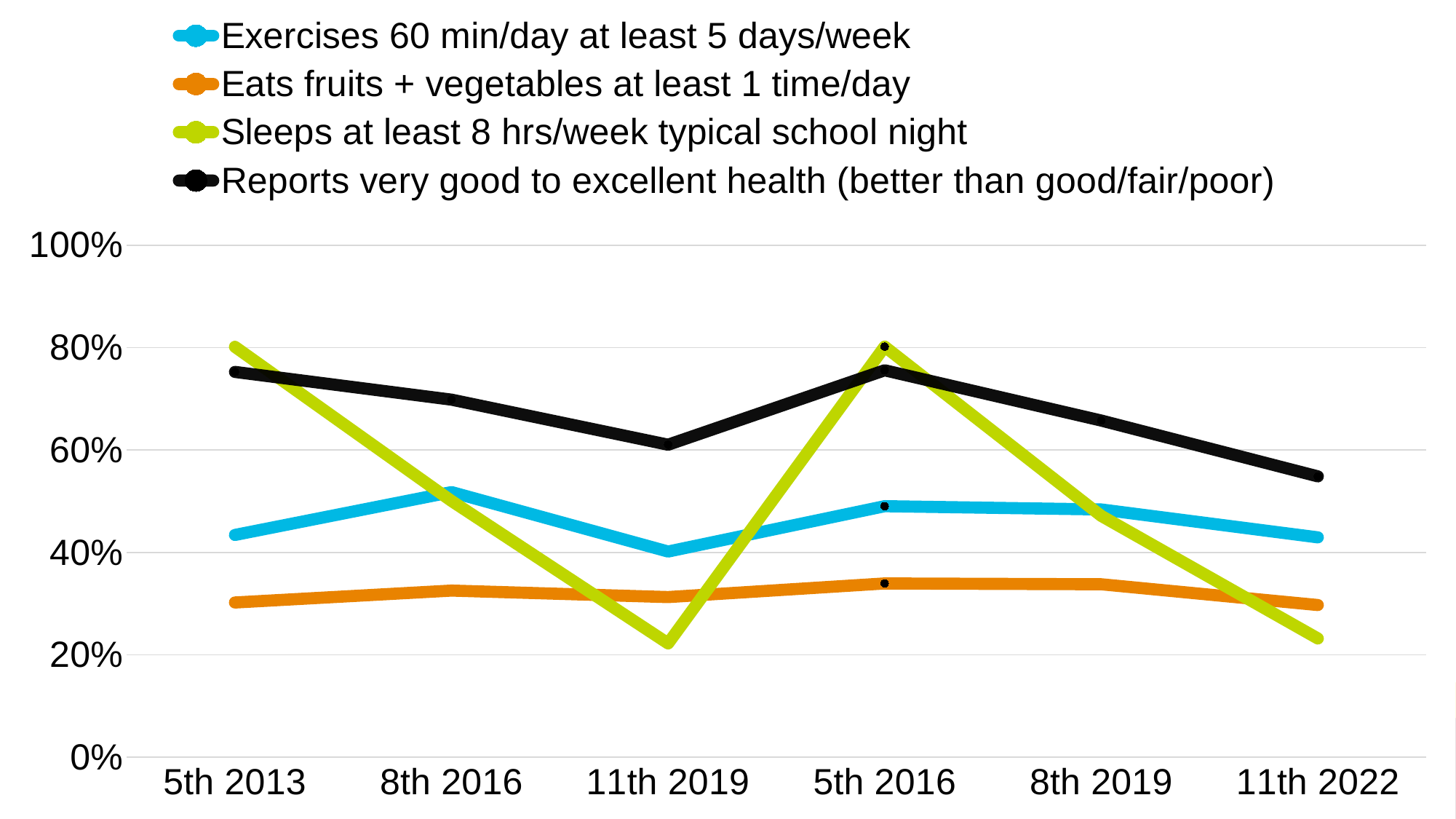
Which series has the lowest value at 11th 2019? Sleeps at least 8 hrs/week typical school night What kind of chart is shown on the slide? line chart Which series has the highest value at 11th 2019? Reports very good to excellent health (better than good/fair/poor) At 11th 2022, which is larger: 'Exercises 60 min/day at least 5 days/week' or 'Eats fruits + vegetables at least 1 time/day'? Exercises 60 min/day at least 5 days/week For 'Reports very good to excellent health', which is larger: the value at 5th 2013 or at 11th 2022? 5th 2013 How many categories are shown along the x axis? 6 What colour is the line for 'Exercises 60 min/day at least 5 days/week'? blue Is the value for 'Reports very good to excellent health' at 5th 2013 greater or less than 60%? greater Is the value for 'Eats fruits + vegetables at least 1 time/day' at 8th 2019 greater or less than 40%? less How many series does the legend list? 4 Is the value for 'Sleeps at least 8 hrs/week typical school night' at 11th 2019 greater or less than 40%? less Does the 'Reports very good to excellent health' line rise or fall from 5th 2016 to 11th 2022? fall